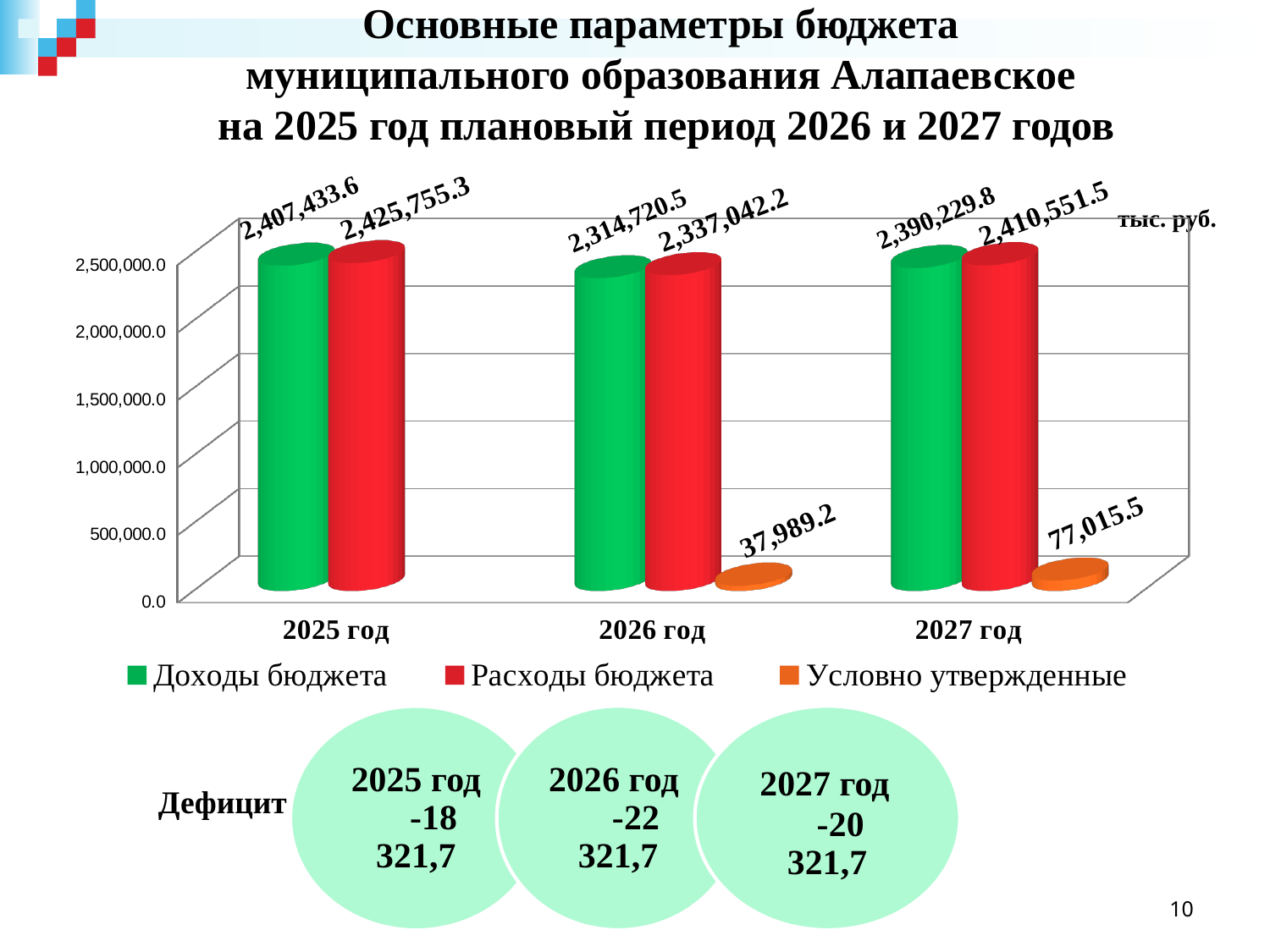
Which is larger for 2026 год: Доходы бюджета or Расходы бюджета? Расходы бюджета Is the value of Доходы бюджета for 2026 год greater or less than 2,500,000.0? less What kind of chart is shown on the slide? bar chart In which year is Доходы бюджета the lowest? 2026 год What is the value of Условно утвержденные for 2027 год? 77,015.5 What is the difference between Расходы бюджета and Доходы бюджета for 2025 год? 18,321.7 How many years are shown on the x axis of the chart? 3 What is the value of Расходы бюджета for 2027 год? 2,410,551.5 How many series does the chart legend list? 3 In which year is Доходы бюджета the highest? 2025 год What is the value of Доходы бюджета for 2025 год? 2,407,433.6 What is the value of Расходы бюджета for 2026 год? 2,337,042.2